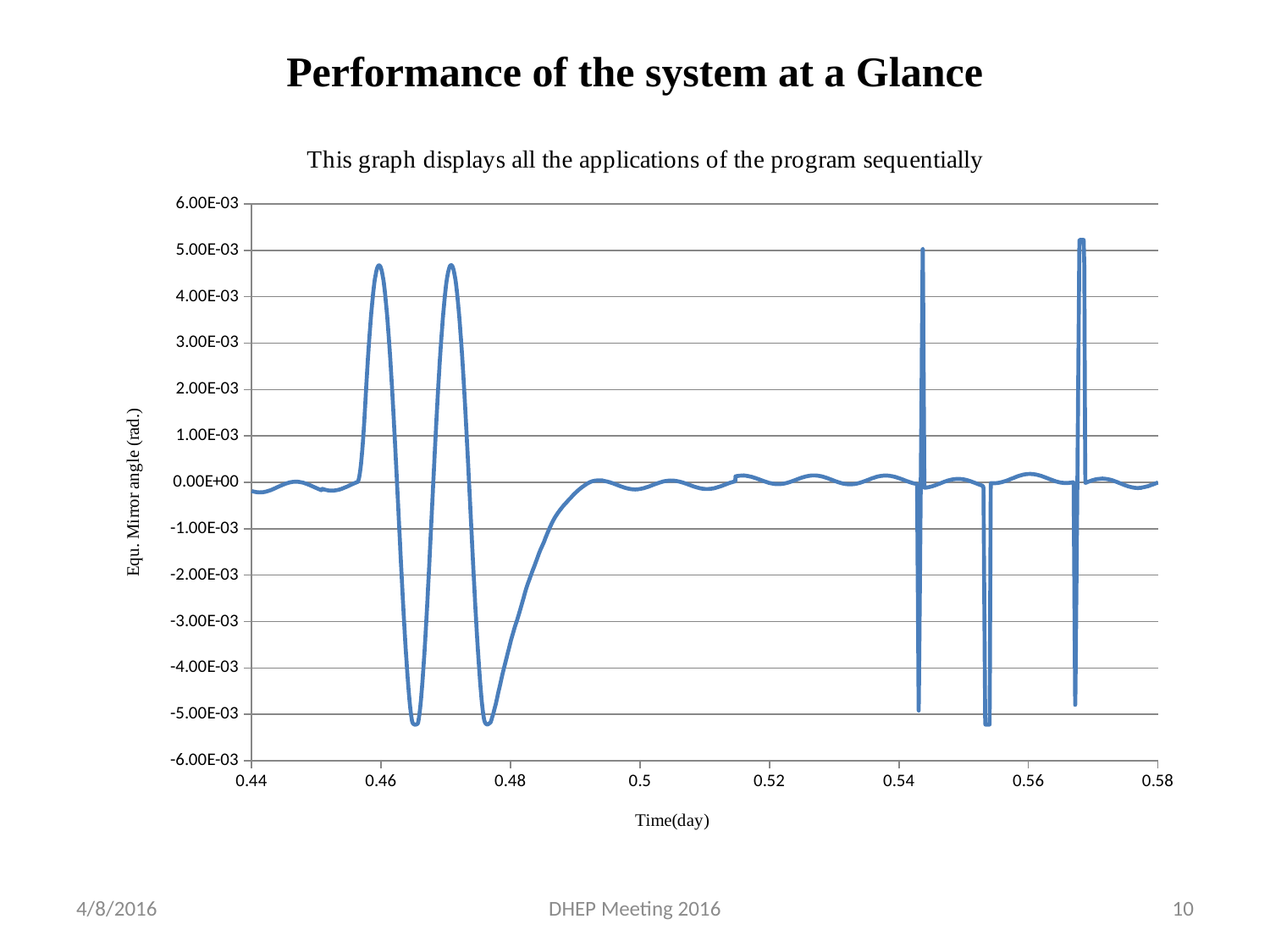
Which is larger: the value of the line at its peak near 0.46 or its value at 0.5? the peak near 0.46 What is the label of the x axis? Time(day) Is the downward spike of the line near 0.553 on the x axis greater or less than -4.00E-03? less Is the peak of the line near 0.471 on the x axis greater or less than 3.00E-03? greater Between 0.48 and 0.49 on the x axis, does the line rise or fall? rise Is the peak of the line near 0.46 on the x axis greater or less than 4.00E-03? greater What is the title of the chart? This graph displays all the applications of the program sequentially What kind of chart is shown on the slide? line chart